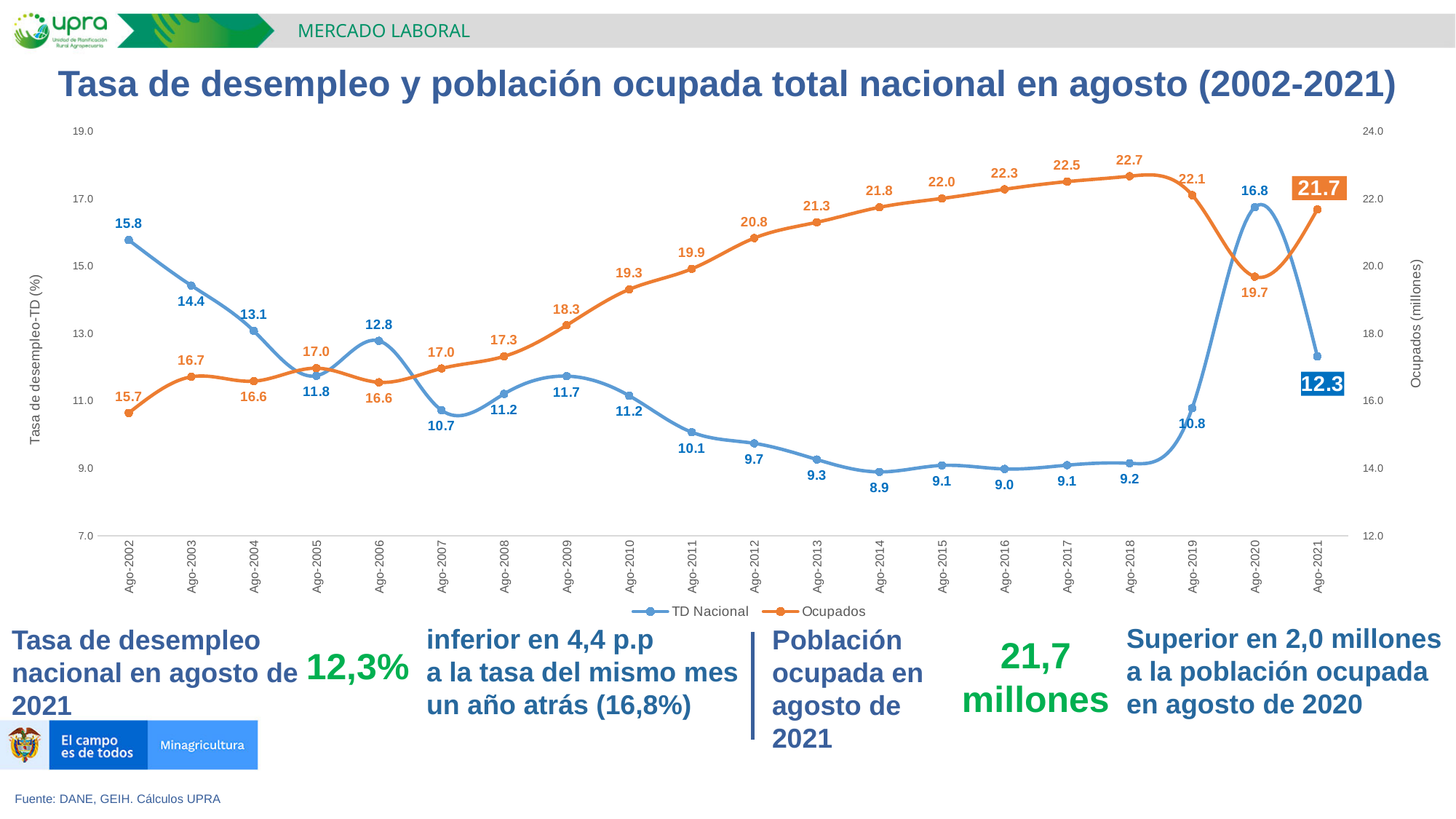
How many series does the legend list? 2 What is the difference between the TD Nacional values for Ago-2020 and Ago-2021? 4.5 In which year does the TD Nacional series reach its highest value? Ago-2020 In which year does the TD Nacional series reach its lowest value? Ago-2014 What is the TD Nacional value for Ago-2002? 15.8 What is the Ocupados value for Ago-2018? 22.7 What is the TD Nacional value for Ago-2021? 12.3 In which year does the Ocupados series reach its lowest value? Ago-2002 How many years (data points) are shown on the x axis? 20 What kind of chart is shown on the slide? Line chart What is the difference between the Ocupados values for Ago-2021 and Ago-2020? 2.0 Which is larger, the Ocupados value for Ago-2018 or for Ago-2019? Ago-2018